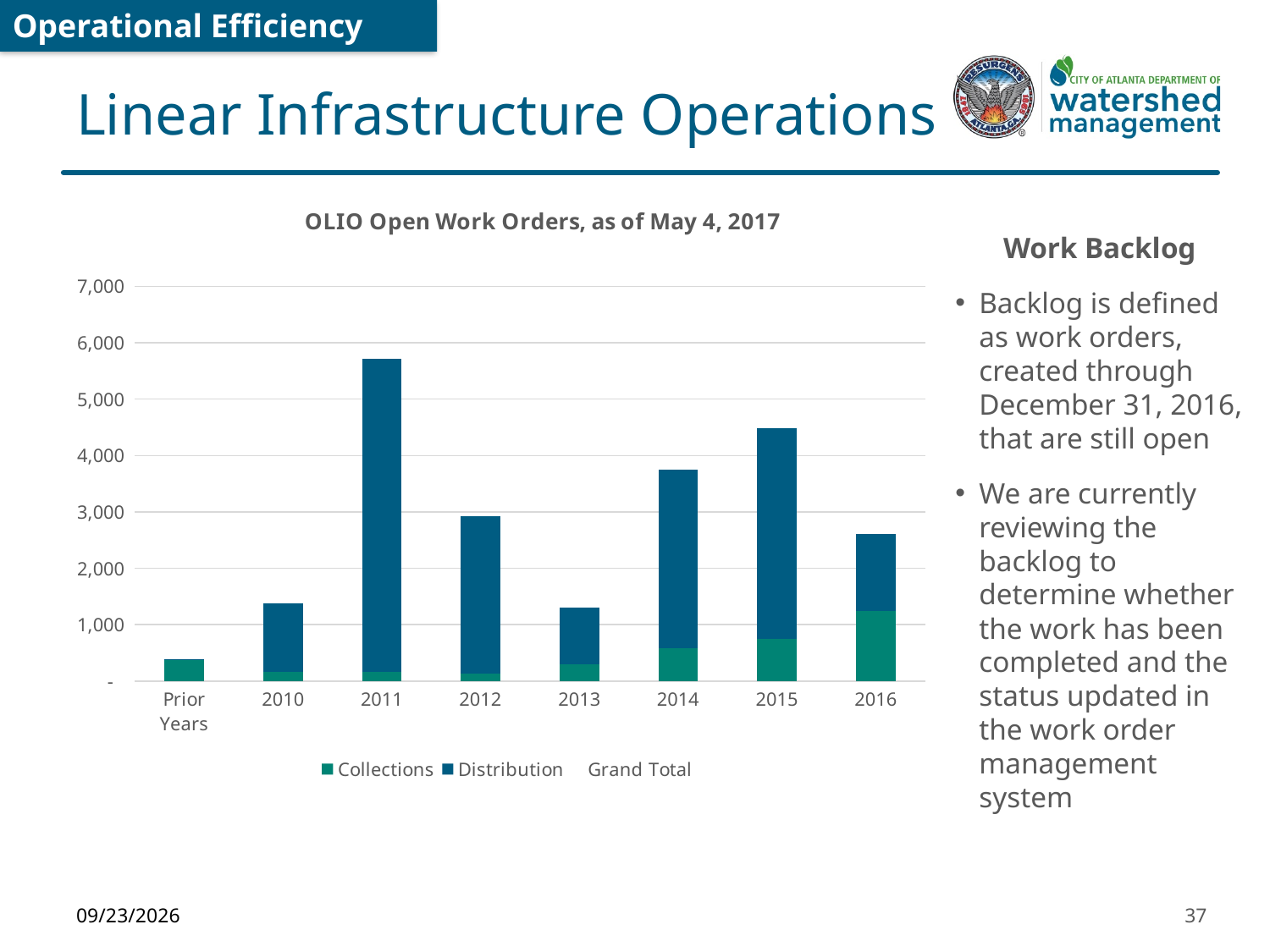
What is the title of the chart? OLIO Open Work Orders, as of May 4, 2017 What kind of chart is shown on the slide? stacked bar chart Which bar is taller, 2014 or 2012? 2014 Is the total bar height for 2013 greater or less than 2,000? less Is the total bar height for 2016 greater or less than 3,000? less Which category has the shortest bar in the chart? Prior Years How many entries does the chart's legend list? 3 Which year has the tallest bar in the chart? 2011 Is the total bar height for 2011 greater or less than 5,000? greater Which series is shown in green in the chart? Collections How many categories are shown along the x axis of the chart? 8